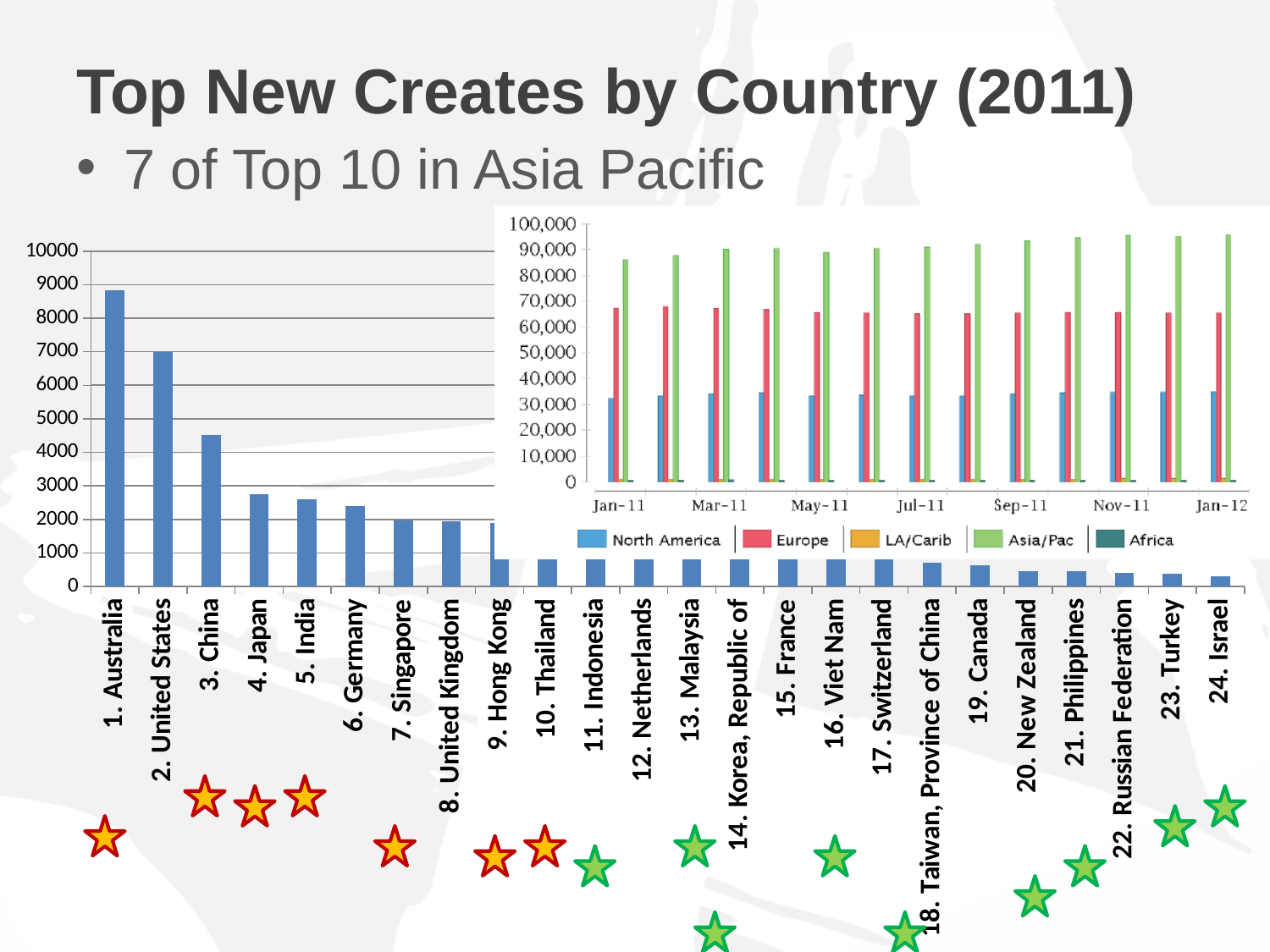
What kind of chart is the large chart of countries? bar chart On the inset monthly chart, do the Asia/Pac values rise or fall from Jan-11 to Jan-12? rise On the large bar chart of countries, which country has the highest value? 1. Australia On the large bar chart of countries, is the value for 3. China greater or less than 4000? greater On the large bar chart of countries, which country has the lowest value? 24. Israel How many countries are shown on the large bar chart? 24 On the large bar chart of countries, is the value for 1. Australia greater or less than 8000? greater On the inset monthly chart, is the Europe value for Jan-11 greater or less than 60,000? greater How many series does the legend of the inset monthly chart list? 5 On the large bar chart of countries, which is larger, the value for 3. China or the value for 4. Japan? 3. China On the inset monthly chart, which region has the highest values across the months? Asia/Pac